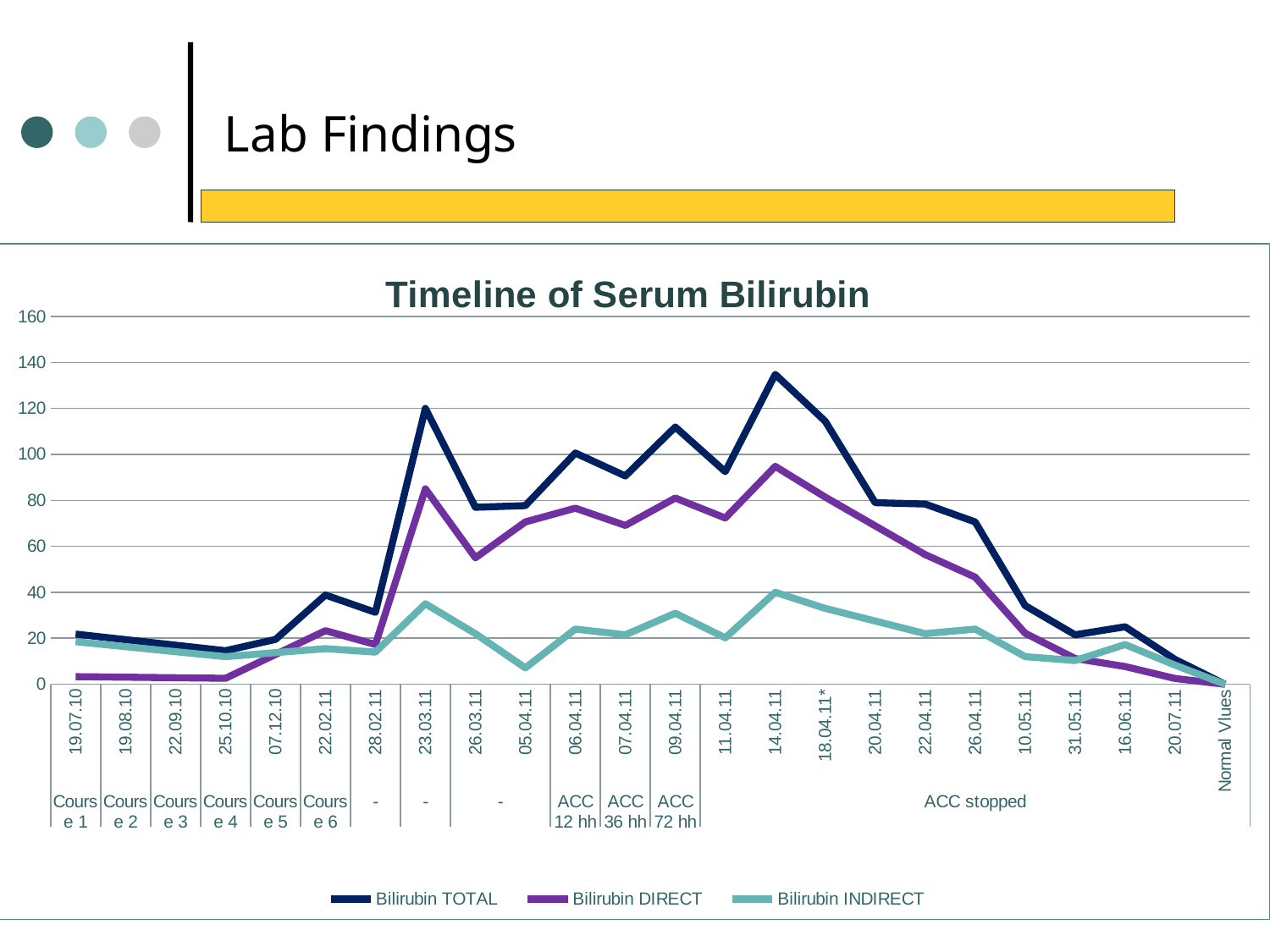
Does Bilirubin TOTAL rise or fall from 14.04.11 to 20.07.11? fall Is the value of Bilirubin INDIRECT on 05.04.11 greater or less than 20? less On which date does Bilirubin TOTAL reach its highest value? 14.04.11 Which series is drawn in purple? Bilirubin DIRECT What type of chart is shown on the slide? line chart Is the value of Bilirubin DIRECT on 14.04.11 greater or less than 80? greater Is the value of Bilirubin DIRECT on 19.07.10 greater or less than 20? less On 14.04.11, which is larger: Bilirubin TOTAL or Bilirubin INDIRECT? Bilirubin TOTAL What is the title of the chart? Timeline of Serum Bilirubin On which date does Bilirubin DIRECT reach its highest value? 14.04.11 How many series does the legend list? 3